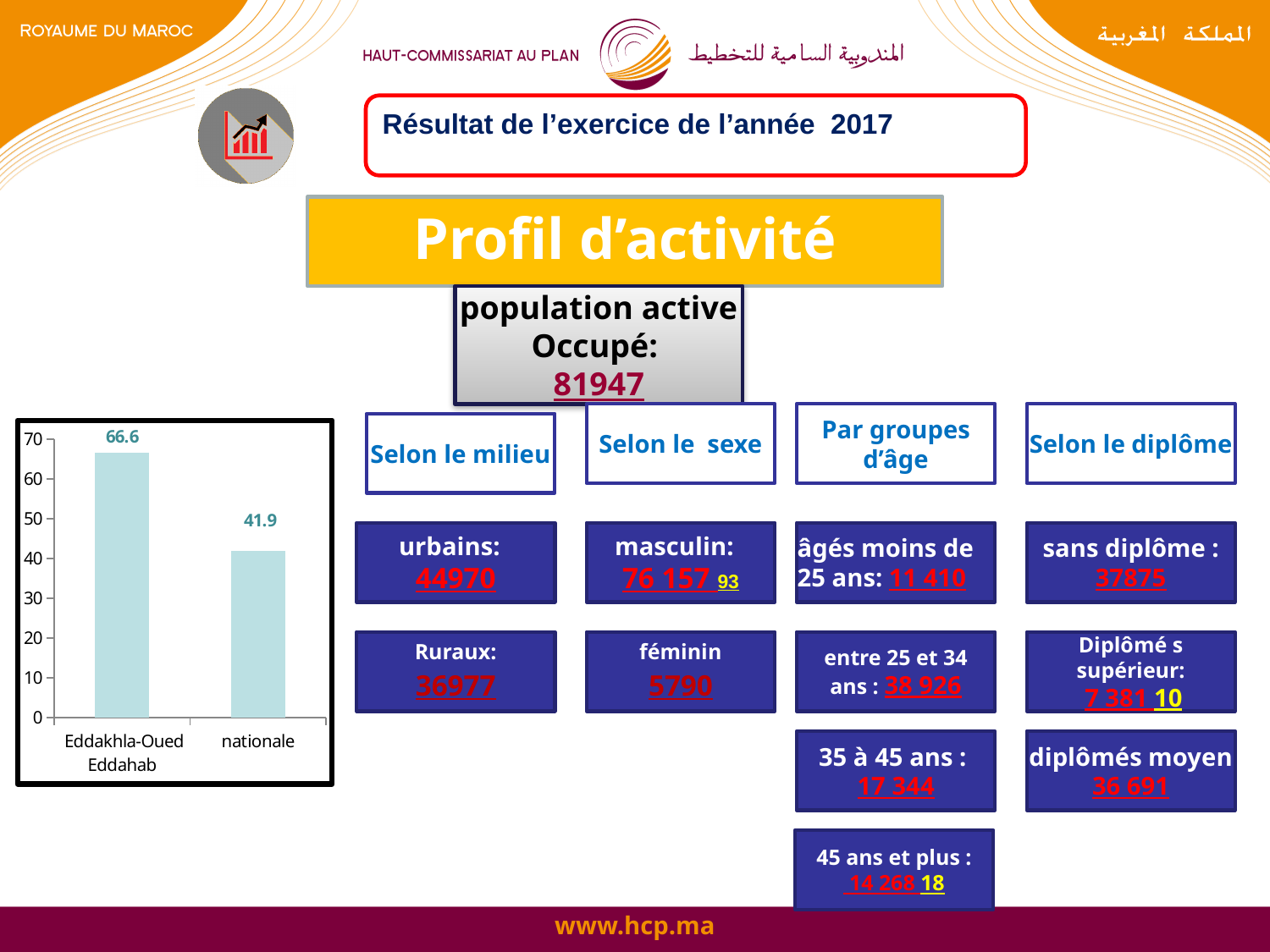
Which category has the lowest value in the bar chart? nationale What kind of chart is shown on the slide? bar chart Do the values in the bar chart rise or fall from left to right? fall How many categories are shown in the bar chart? 2 Which category has the highest value in the bar chart? Eddakhla-Oued Eddahab What is the value for nationale in the bar chart? 41.9 What is the value for Eddakhla-Oued Eddahab in the bar chart? 66.6 Which is larger in the bar chart, the value for Eddakhla-Oued Eddahab or the value for nationale? Eddakhla-Oued Eddahab What is the difference between the values for Eddakhla-Oued Eddahab and nationale in the bar chart? 24.7 Is the value for nationale in the bar chart greater or less than 50? less Is the value for Eddakhla-Oued Eddahab in the bar chart greater or less than 60? greater What is the highest tick value shown on the y axis of the bar chart? 70